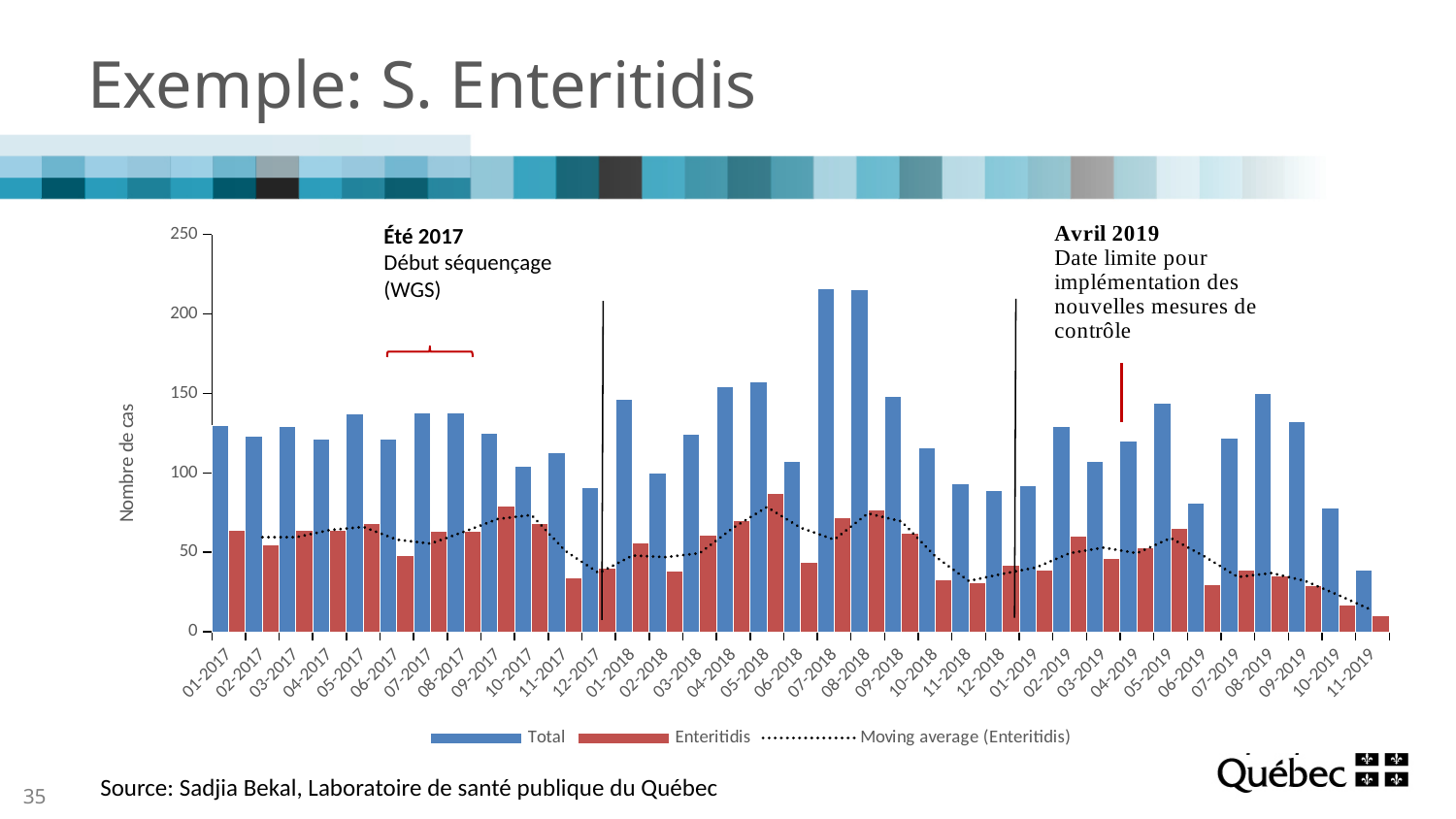
How many series does the legend list? 3 Which month has the lowest Enteritidis value? 11-2019 What kind of chart is shown on the slide? bar chart Is the Total value for 11-2019 greater or less than 50? less What event does the annotation for Été 2017 describe? Début séquençage (WGS) Is the Total value for 07-2018 greater or less than 200? greater Is the Enteritidis value for 05-2018 greater or less than 50? greater Which is larger, the Total value for 08-2018 or the Total value for 11-2018? 08-2018 How many months are shown on the x axis? 35 Which month has the lowest Total value? 11-2019 What is the label of the y axis? Nombre de cas